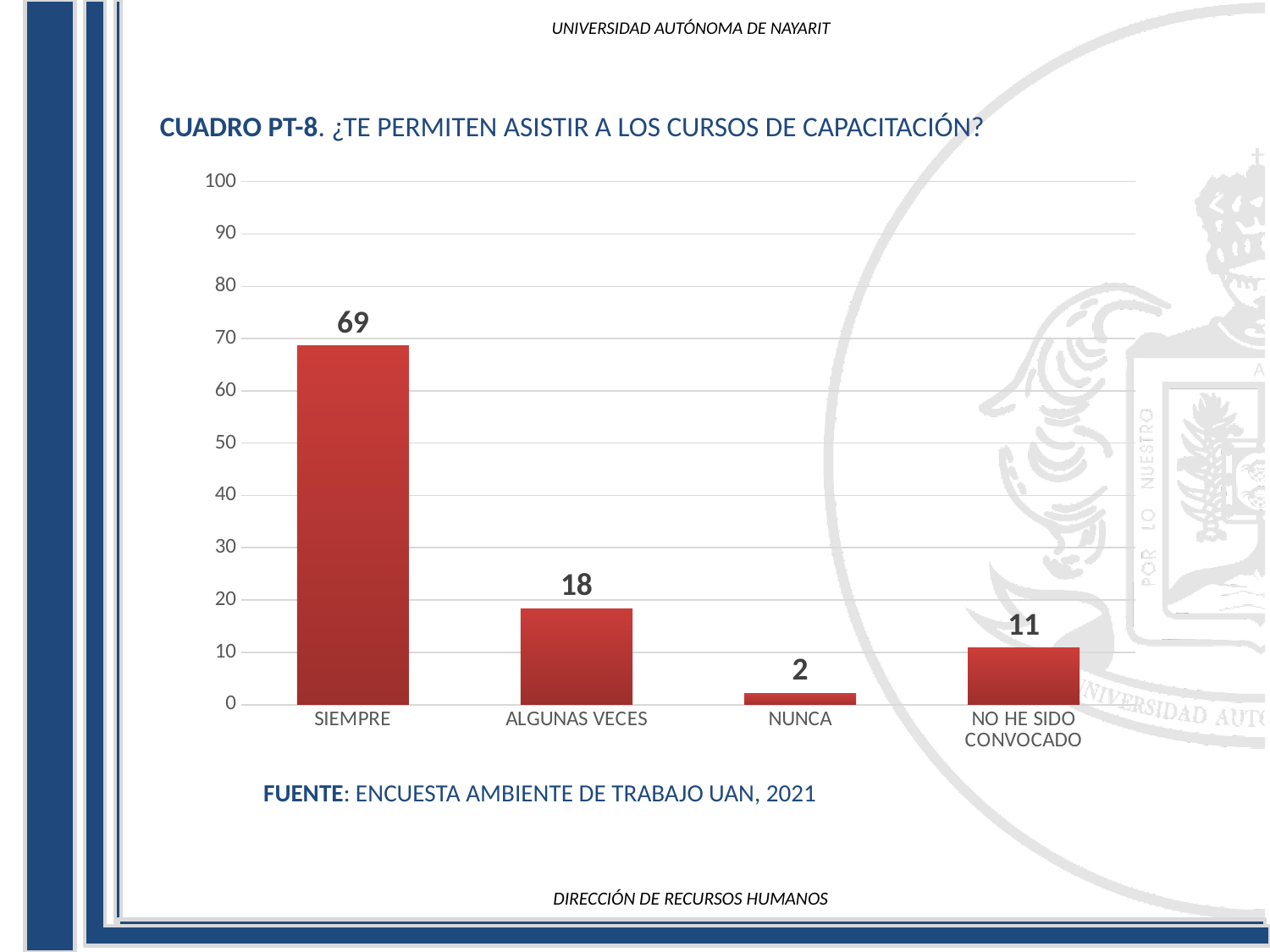
Is the value for SIEMPRE greater or less than 60? greater Which is larger, the value for ALGUNAS VECES or the value for NO HE SIDO CONVOCADO? ALGUNAS VECES Which category has the lowest value? NUNCA How many categories are shown on the x axis? 4 What is the value for ALGUNAS VECES? 18 What is the value for NUNCA? 2 What is the title of the chart? CUADRO PT-8. ¿TE PERMITEN ASISTIR A LOS CURSOS DE CAPACITACIÓN? Which category has the highest value? SIEMPRE What is the difference between the values for SIEMPRE and ALGUNAS VECES? 51 What is the value for NO HE SIDO CONVOCADO? 11 What is the value for SIEMPRE? 69 What kind of chart is shown on the slide? bar chart